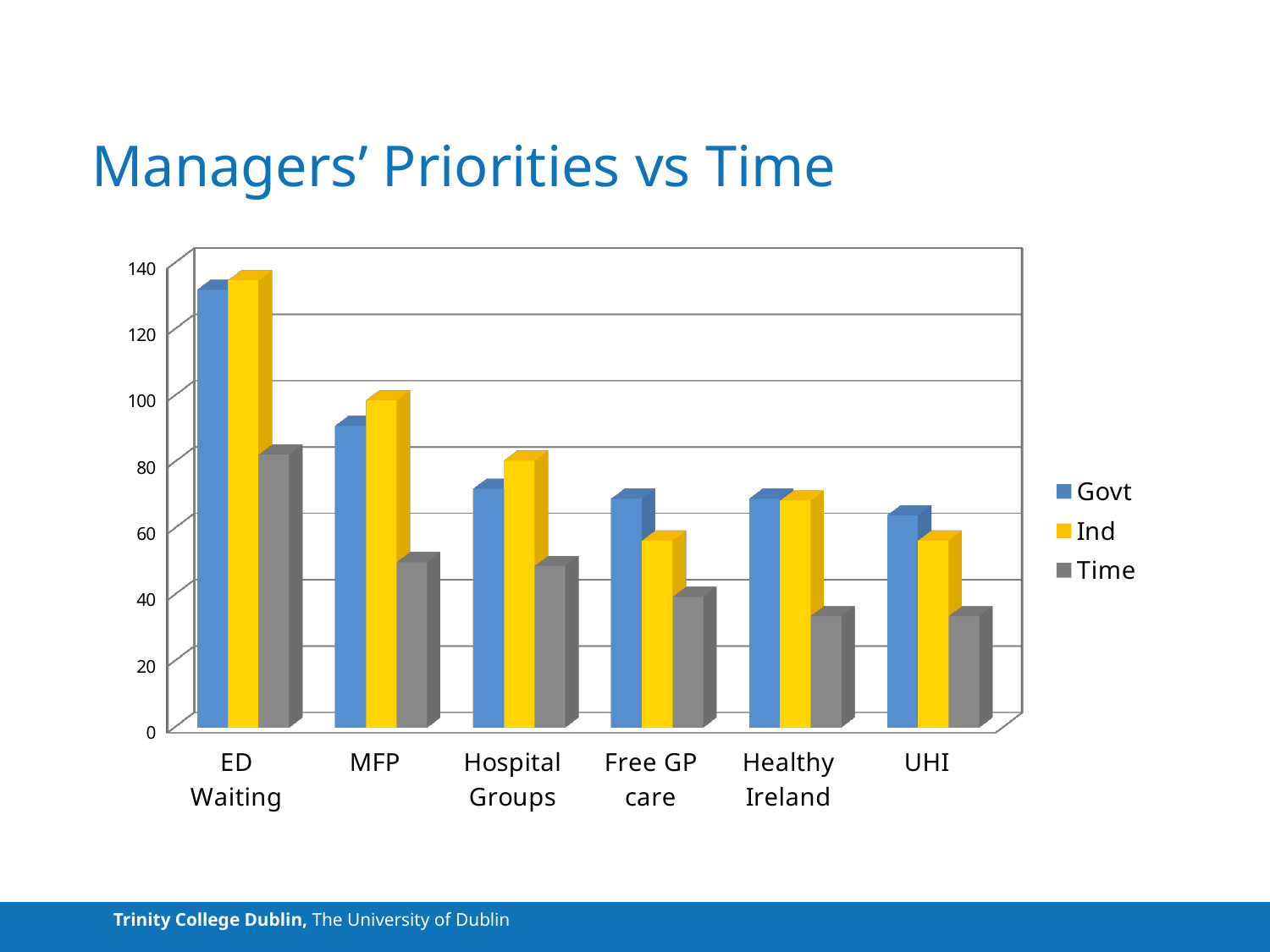
Which category has the highest Govt value? ED Waiting How many series does the legend list? 3 How many categories are shown on the x axis? 6 Which is larger, the Govt value for ED Waiting or the Govt value for MFP? ED Waiting Which category has the highest Ind value? ED Waiting Is the Govt value for Hospital Groups greater or less than 60? greater Is the Govt value for ED Waiting greater or less than 120? greater Is the Time value for Healthy Ireland greater or less than 40? less What is the title of the chart? Managers' Priorities vs Time What type of chart is shown on the slide? bar chart Do the Govt values generally rise or fall from ED Waiting to UHI? fall Which category has the highest Time value? ED Waiting